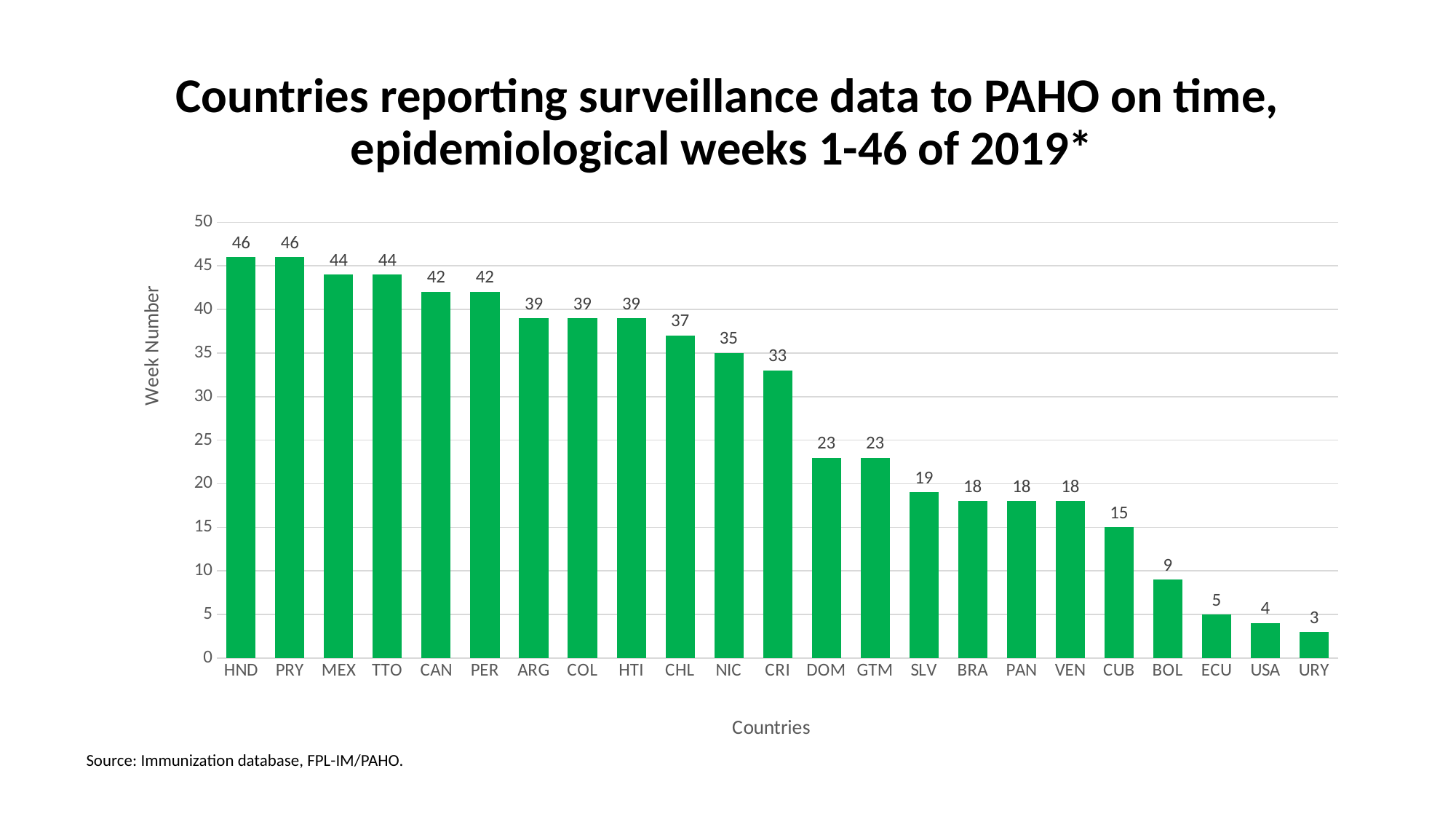
What is the value for NIC? 35 What is the value for CHL? 37 Which has a larger value, SLV or BOL? SLV Do the values rise or fall from left to right along the x axis? Fall What is the value for CUB? 15 What is the difference between the values for HND and URY? 43 What kind of chart is this? Bar chart How many countries are shown on the x axis? 23 What is the difference between the values for CRI and DOM? 10 What is the label of the y axis? Week Number Which country has the lowest value? URY Which has a larger value, MEX or CAN? MEX